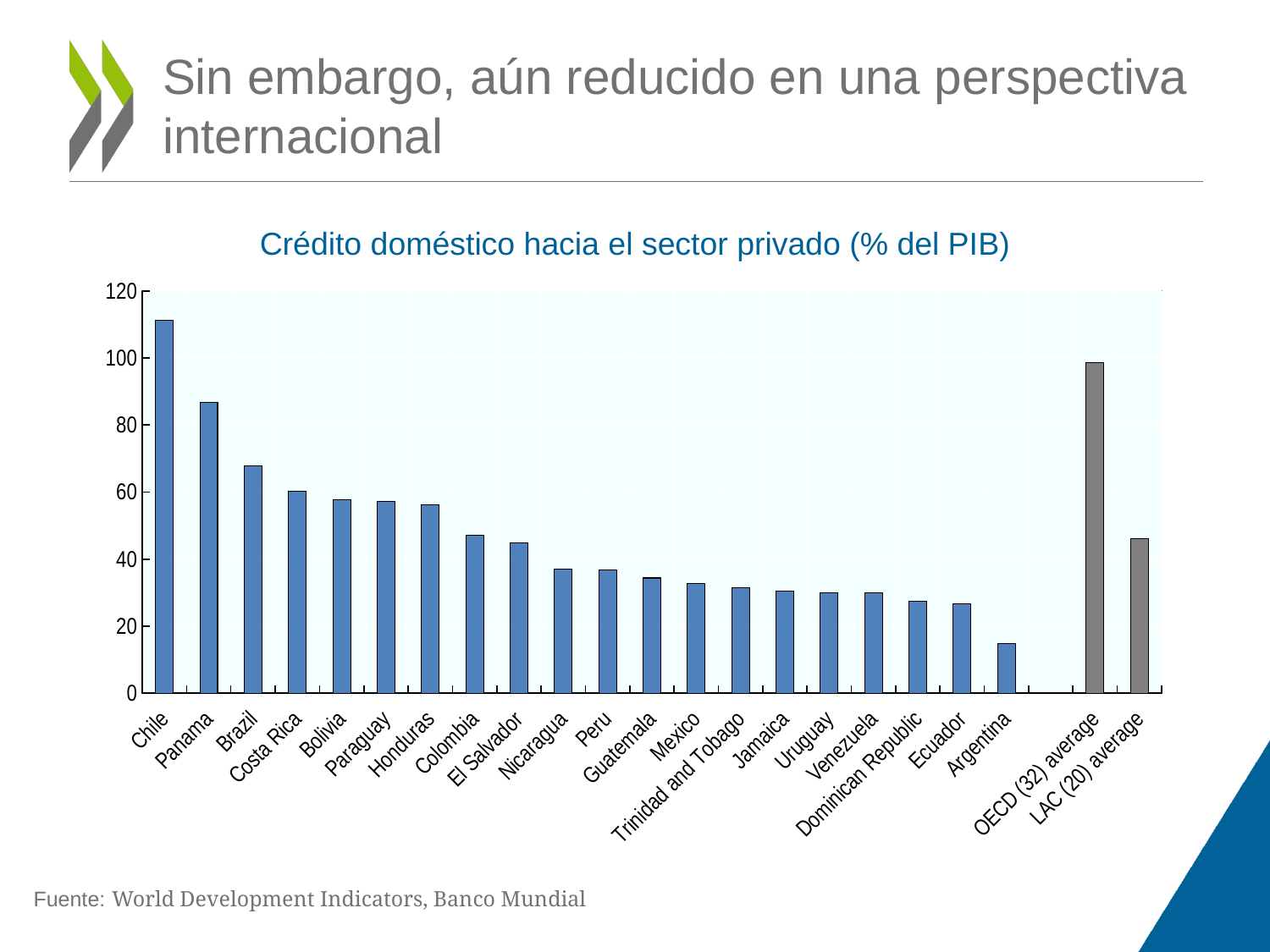
What is the title of the chart? Crédito doméstico hacia el sector privado (% del PIB) Which country has the highest domestic credit to the private sector as a share of GDP? Chile Which is larger, the value for Panama or the value for Brazil? Panama Is the value for Chile greater or less than 100? greater Is the value for OECD (32) average greater or less than 80? greater Is the value for Mexico greater or less than 40? less Which is larger, the OECD (32) average or the LAC (20) average? OECD (32) average What kind of chart is shown on the slide? Bar chart Do the values rise or fall moving along the x axis from Chile to Argentina? fall How many bars are plotted in the chart? 22 Which country has the lowest domestic credit to the private sector as a share of GDP? Argentina